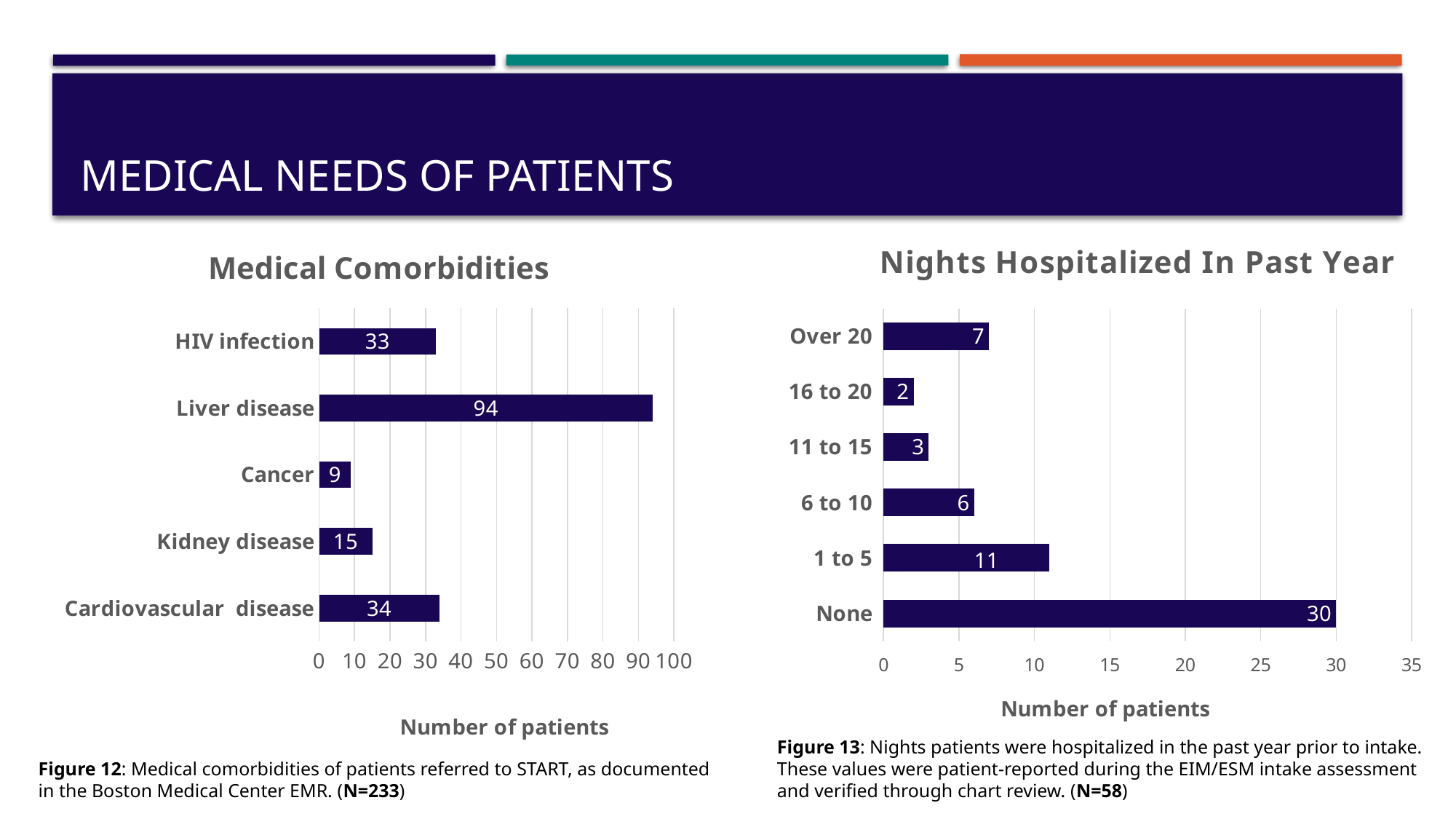
In the Medical Comorbidities chart, how many patients have liver disease? 94 In the Nights Hospitalized In Past Year chart, how many patients reported 1 to 5 nights? 11 In the Nights Hospitalized In Past Year chart, which has more patients: Over 20 or 6 to 10? Over 20 In the Medical Comorbidities chart, is the value for kidney disease greater or less than 20? less In the Medical Comorbidities chart, what is the difference between the number of patients with liver disease and the number with HIV infection? 61 In the Nights Hospitalized In Past Year chart, which category has the highest number of patients? None In the Medical Comorbidities chart, which comorbidity has the most patients? Liver disease In the Medical Comorbidities chart, how many comorbidity categories are shown? 5 What type of chart is the Nights Hospitalized In Past Year chart? Bar chart In the Medical Comorbidities chart, which comorbidity has the fewest patients? Cancer In the Nights Hospitalized In Past Year chart, which category has the lowest number of patients? 16 to 20 In the Nights Hospitalized In Past Year chart, how many categories are shown? 6